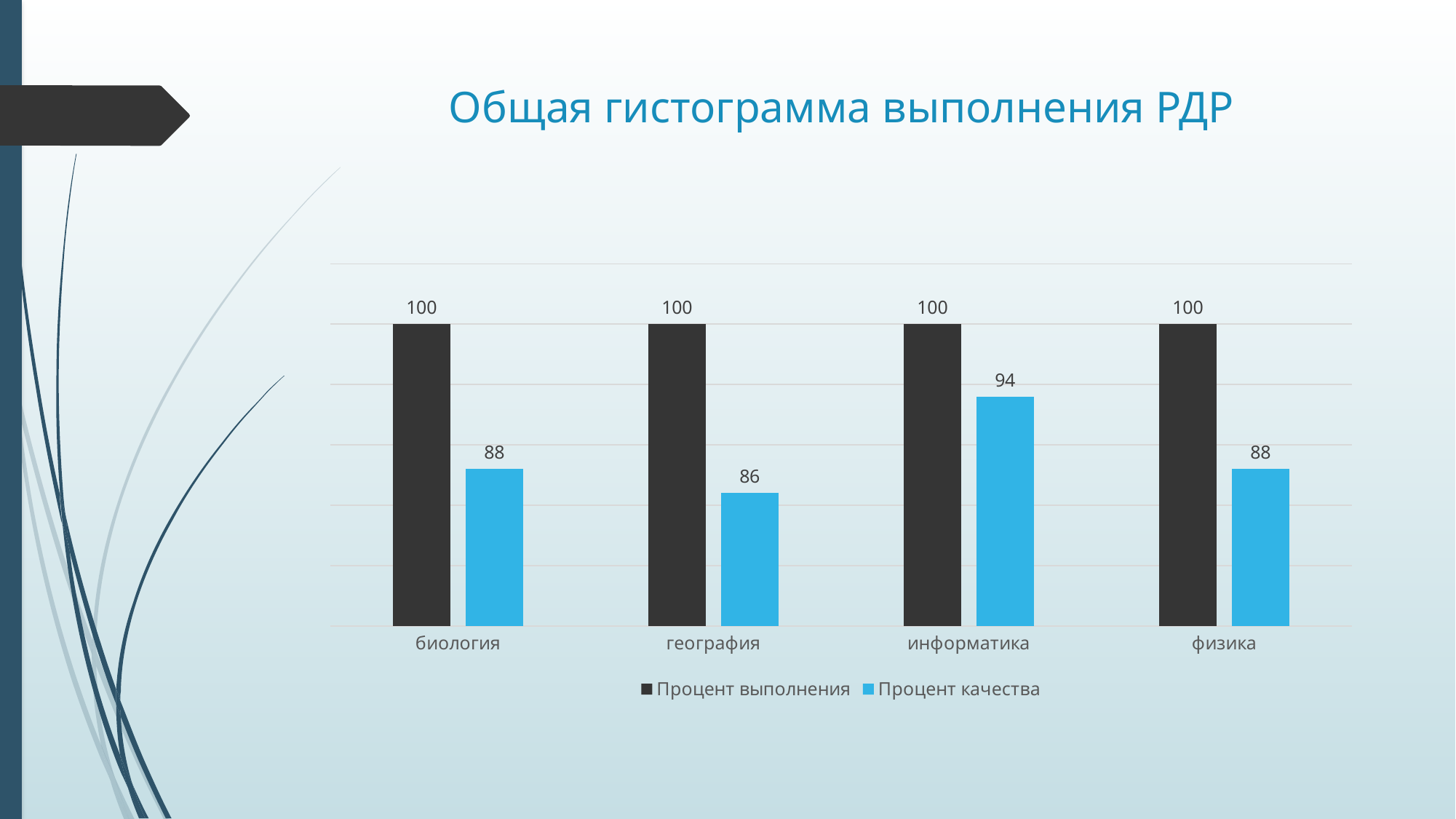
What is the value of Процент выполнения for физика? 100 What is the title of the chart? Общая гистограмма выполнения РДР What is the value of Процент качества for география? 86 What is the difference between Процент качества for информатика and for география? 8 How many categories are shown on the x axis? 4 What is the value of Процент качества for информатика? 94 Which is larger: Процент качества for информатика or for физика? информатика How many series does the legend list? 2 What is the difference between Процент выполнения and Процент качества for биология? 12 Which category has the highest Процент качества? информатика What kind of chart is shown on the slide? bar chart Which category has the lowest Процент качества? география